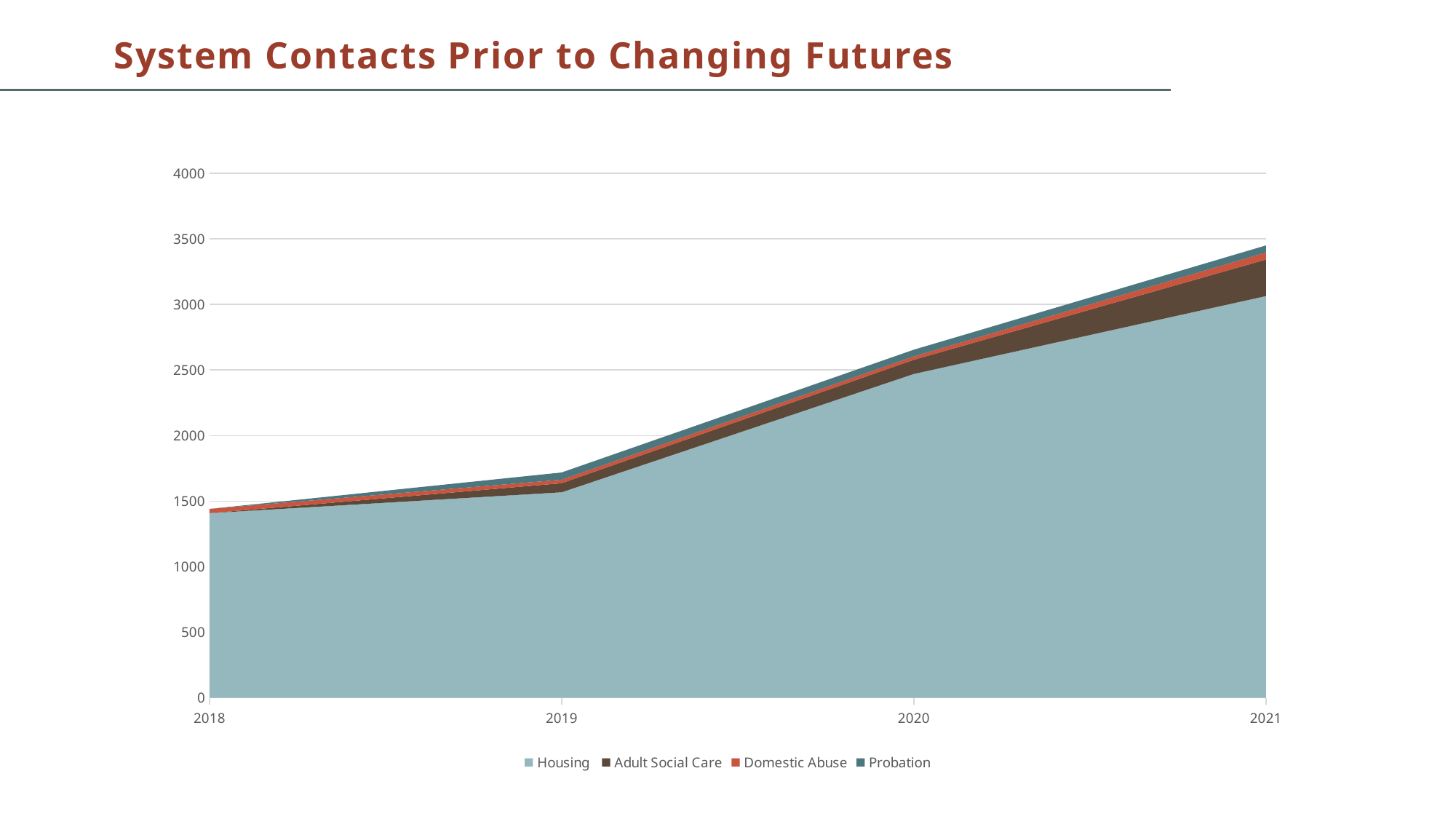
Is the total of all series in 2019 greater or less than 2000? less Which year has the lowest value for Housing? 2018 Is the value for Housing in 2018 greater or less than 1500? less Is the value for Housing in 2021 greater or less than 3000? greater Which year has the highest value for Housing? 2021 Do the total system contacts rise or fall from 2018 to 2021? Rise How many years are shown on the x axis? 4 What is the title of the chart? System Contacts Prior to Changing Futures How many series does the legend list? 4 What kind of chart is shown on the slide? Stacked area chart Which is larger, the Housing value in 2020 or the Housing value in 2019? 2020